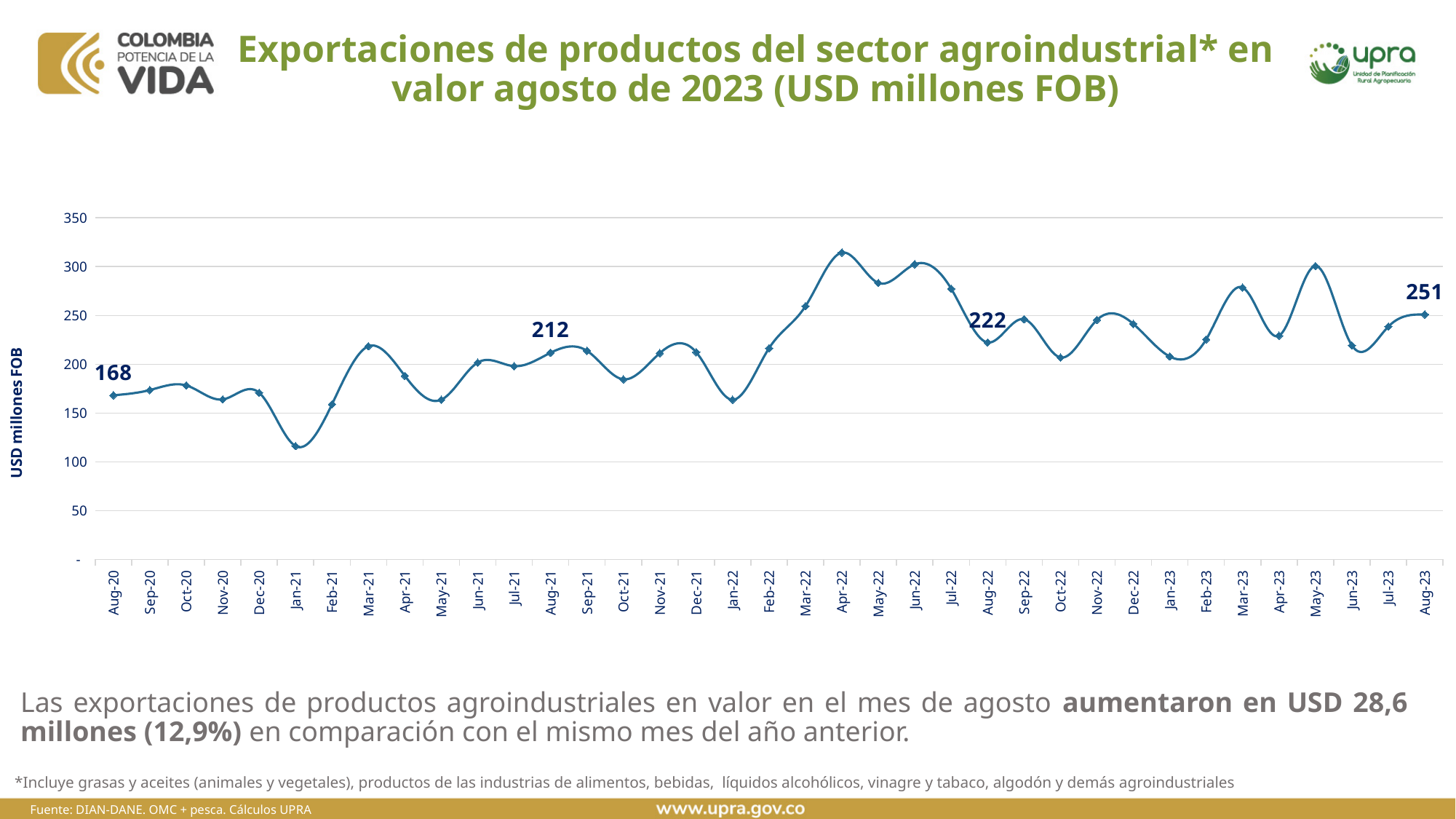
What is the title of the vertical axis? USD millones FOB Is the value for Jan-21 greater or less than 150? less What is the difference between the export values for Aug-23 and Aug-22? 29 How many monthly data points are plotted on the chart? 37 What is the export value for Aug-20? 168 Which month has the lowest export value on the chart? Jan-21 What is the export value for Aug-23? 251 What is the difference between the export values for Aug-23 and Aug-20? 83 What kind of chart is shown on the slide? line chart Which month has the highest export value on the chart? Apr-22 What is the export value for Aug-22? 222 What is the export value for Aug-21? 212